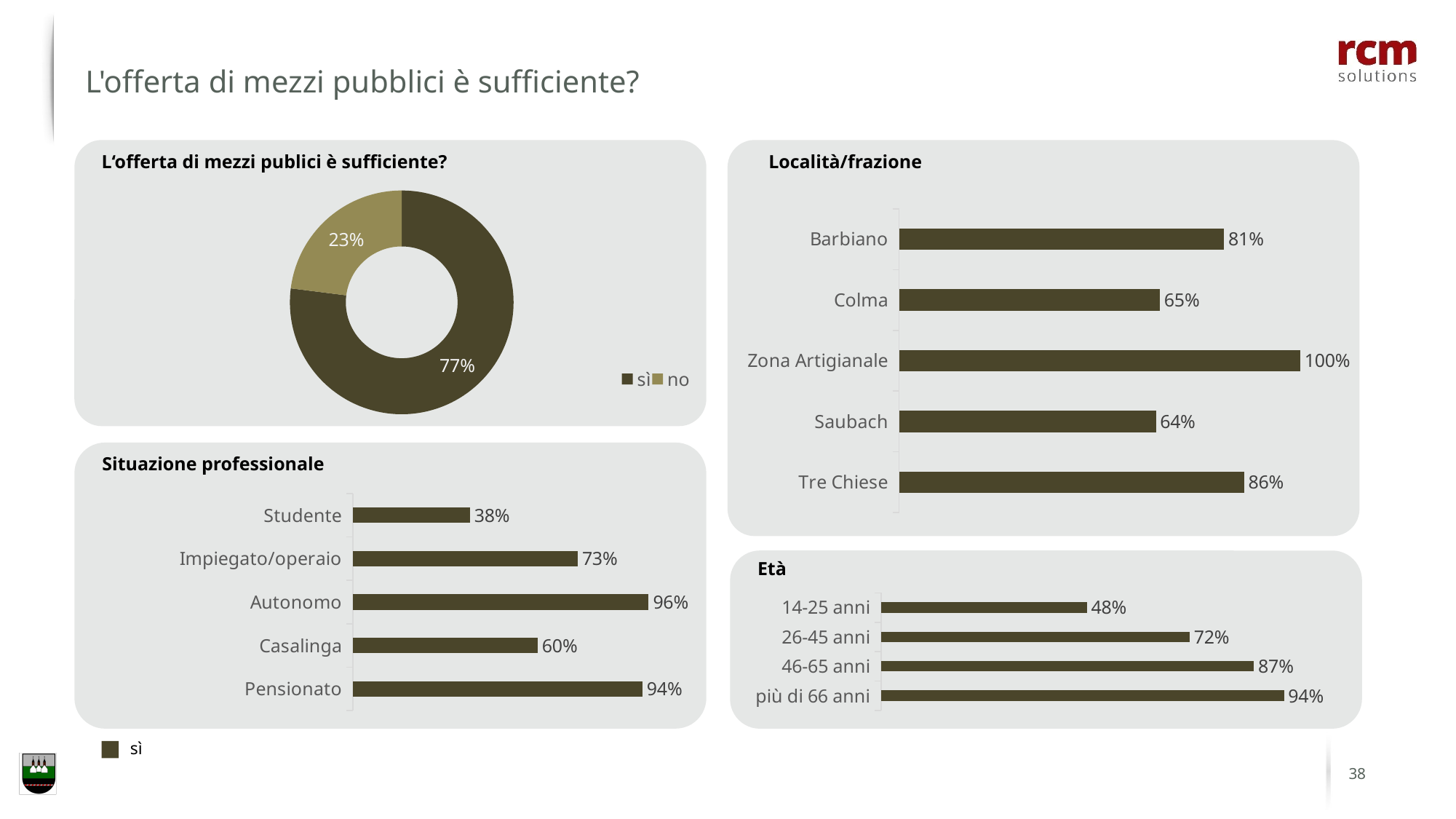
In the 'L'offerta di mezzi publici è sufficiente?' donut chart, what share answered 'no'? 23% In the 'Località/frazione' chart, what is the value for Zona Artigianale? 100% What kind of chart is the 'L'offerta di mezzi publici è sufficiente?' chart? Donut (pie) chart How many categories are shown in the 'Località/frazione' chart? 5 In the 'Località/frazione' chart, what is the difference between Tre Chiese and Colma? 21% In the 'Situazione professionale' chart, which is larger, Impiegato/operaio or Studente? Impiegato/operaio In the 'Località/frazione' chart, which category has the lowest value? Saubach In the 'Situazione professionale' chart, what is the value for Casalinga? 60% In the 'Età' chart, what is the value for 46-65 anni? 87% In the 'Situazione professionale' chart, which category has the highest value? Autonomo In the 'L'offerta di mezzi publici è sufficiente?' donut chart, what share answered 'sì'? 77% In the 'Età' chart, do the values rise or fall as age increases from '14-25 anni' to 'più di 66 anni'? Rise